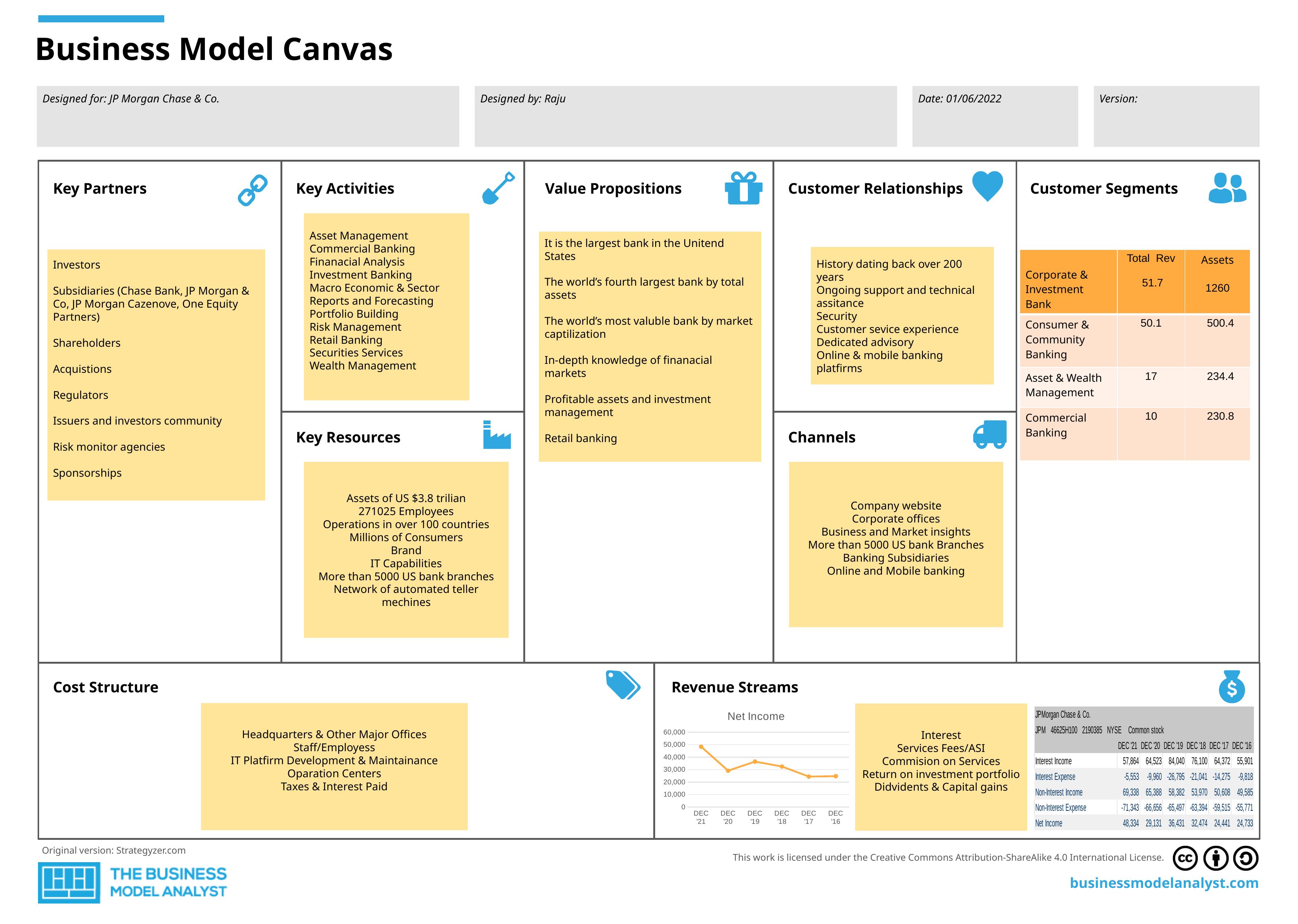
On the Net Income chart, which is larger, the value for DEC '21 or DEC '20? DEC '21 What kind of chart is the Net Income chart in the Revenue Streams section? line chart On the Net Income chart, is the value for DEC '20 greater or less than 40,000? less On the Net Income chart, is the value for DEC '19 greater or less than 30,000? greater What is the title of the chart in the Revenue Streams section? Net Income On the Net Income chart, which period has the highest value? DEC '21 On the Net Income chart, which is larger, the value for DEC '19 or DEC '17? DEC '19 On the Net Income chart, is the value for DEC '21 greater or less than 40,000? greater How many data points are plotted on the Net Income chart? 6 What is the highest tick value shown on the y axis of the Net Income chart? 60,000 On the Net Income chart, do the values generally rise or fall moving from DEC '21 on the left to DEC '16 on the right? fall